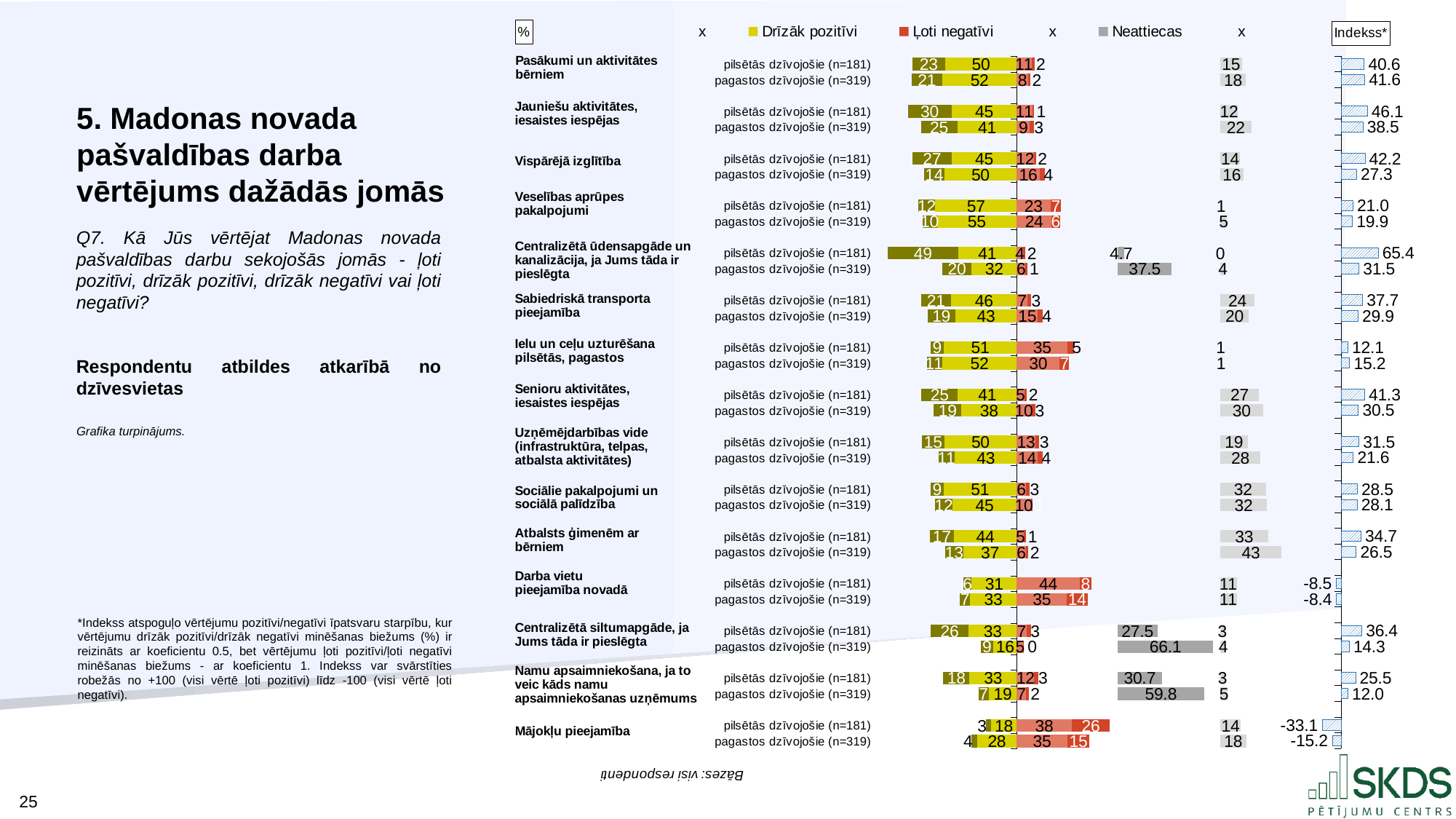
What kind of chart is used to show the evaluation results? Stacked bar chart What is the difference between the index values for 'Vispārējā izglītība' among pilsētās dzīvojošie (42.2) and pagastos dzīvojošie (27.3)? 14.9 Which area and respondent group has the highest index (Indekss*) value on the chart? Centralizētā ūdensapgāde un kanalizācija, pilsētās dzīvojošie (65.4) What is the index (Indekss*) value for 'Centralizētā ūdensapgāde un kanalizācija, ja Jums tāda ir pieslēgta' among pilsētās dzīvojošie (n=181)? 65.4 For 'Darba vietu pieejamība novadā', which group has the larger 'Ļoti negatīvi' share: pilsētās dzīvojošie or pagastos dzīvojošie? pagastos dzīvojošie For 'Jauniešu aktivitātes, iesaistes iespējas', which group has the higher index value: pilsētās dzīvojošie or pagastos dzīvojošie? pilsētās dzīvojošie What is the 'Neattiecas' value for 'Centralizētā siltumapgāde, ja Jums tāda ir pieslēgta' among pagastos dzīvojošie (n=319)? 66.1 Which area and respondent group has the lowest index (Indekss*) value on the chart? Mājokļu pieejamība, pilsētās dzīvojošie (-33.1) What is the index (Indekss*) value for 'Mājokļu pieejamība' among pagastos dzīvojošie (n=319)? -15.2 How many areas (jomas) are evaluated on the chart? 15 What percentage of pilsētās dzīvojošie (n=181) answered 'Drīzāk pozitīvi' for 'Veselības aprūpes pakalpojumi'? 57 What is the index (Indekss*) value for 'Ielu un ceļu uzturēšana pilsētās, pagastos' among pilsētās dzīvojošie (n=181)? 12.1